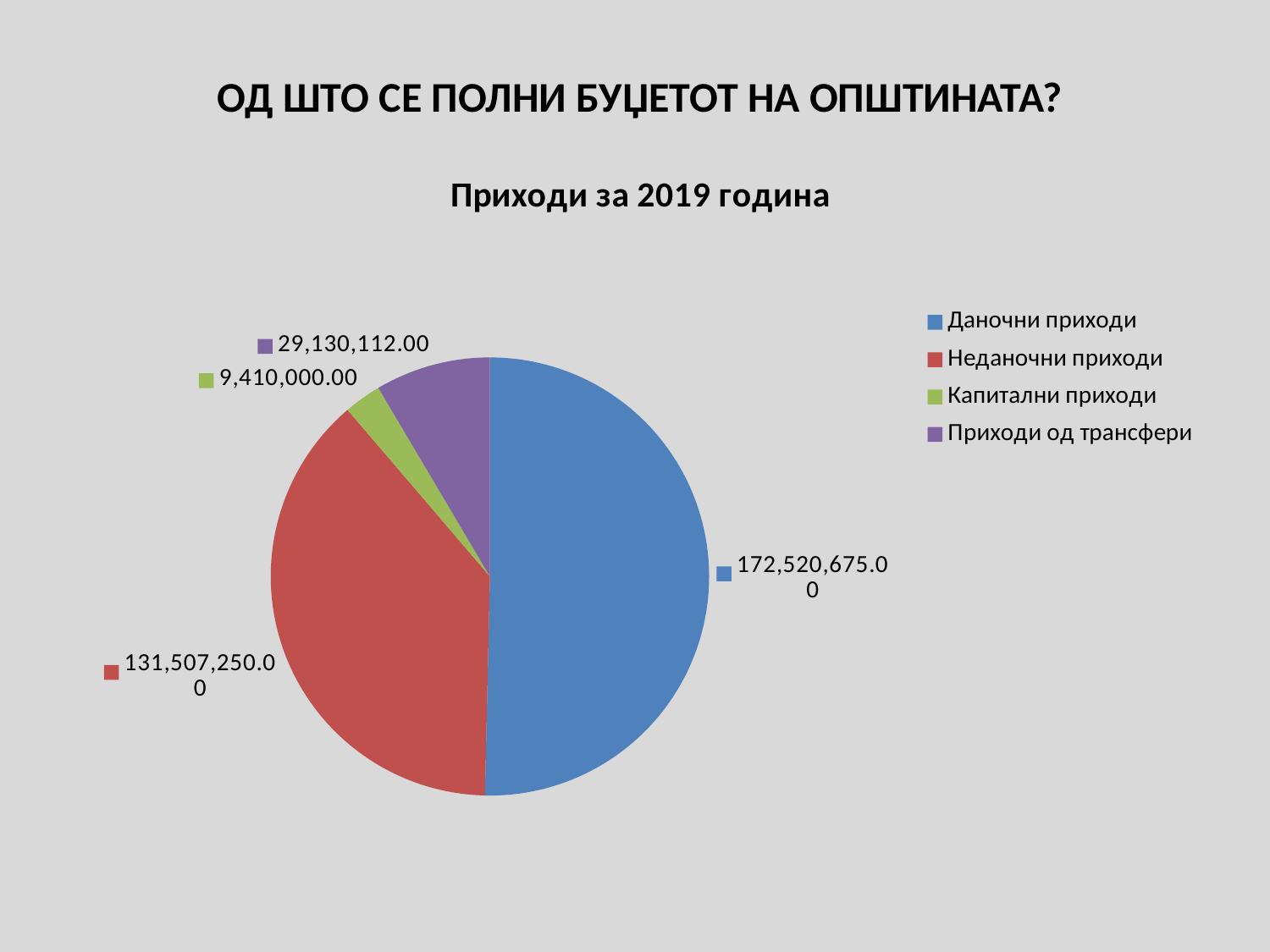
What is the title of the chart? Приходи за 2019 година What type of chart is shown on the slide? Pie chart How many categories does the legend list? 4 What is the value for Неданочни приходи? 131,507,250.00 What colour is the slice for Неданочни приходи? Red Which category has the smallest slice of the pie? Капитални приходи What is the difference between the values for Даночни приходи and Неданочни приходи? 41,013,425.00 Which category has the largest slice of the pie? Даночни приходи What is the value for Капитални приходи? 9,410,000.00 Which is larger, Приходи од трансфери or Капитални приходи? Приходи од трансфери What is the value for Приходи од трансфери? 29,130,112.00 What is the value for Даночни приходи? 172,520,675.00